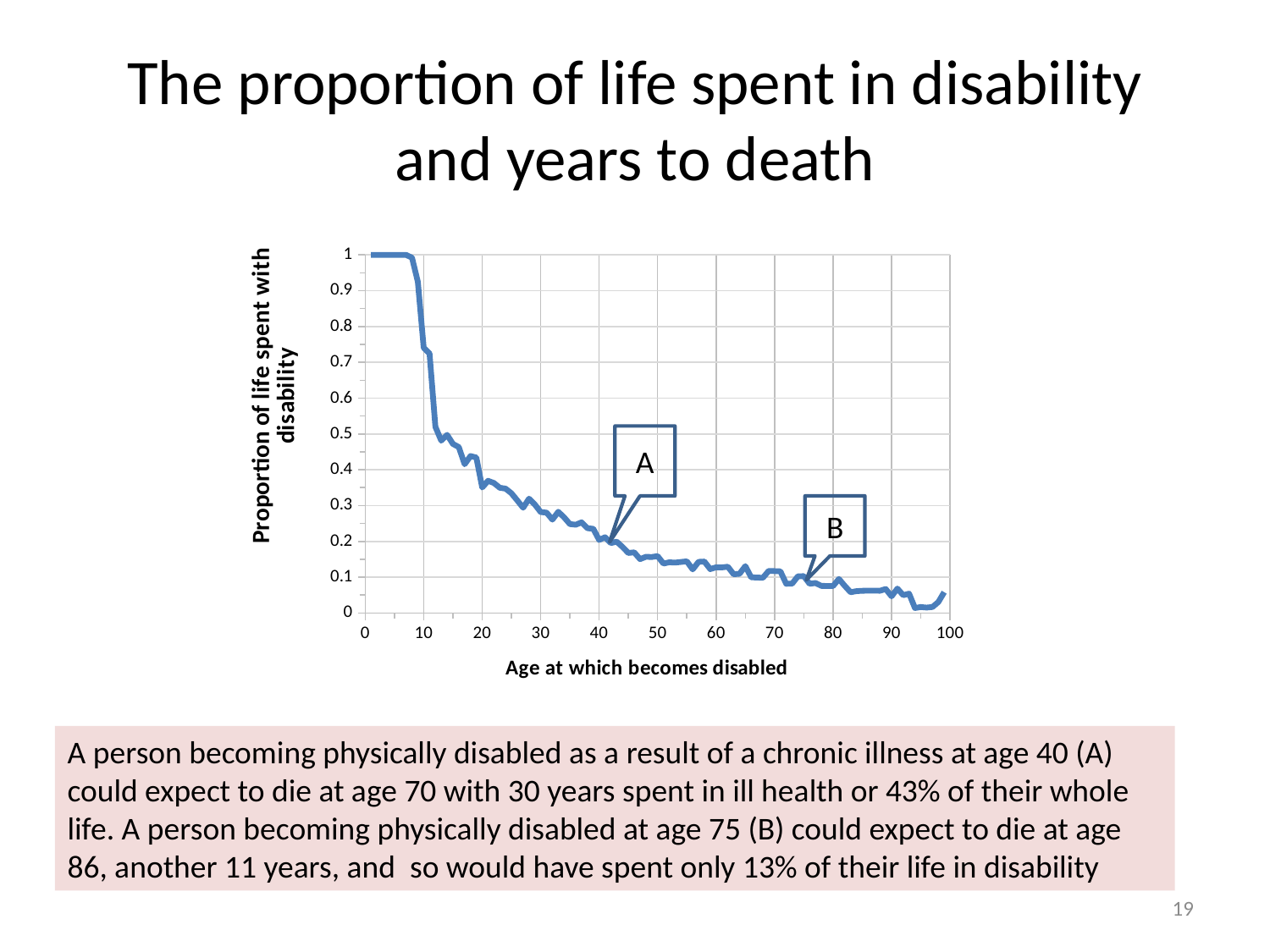
Does the proportion of life spent with disability rise or fall as the age at which a person becomes disabled increases? Fall Is the proportion of life spent with disability at age 40 greater or less than 0.3? less At which end of the age range is the proportion of life spent with disability highest? The youngest ages (near 0) Is the proportion of life spent with disability at age 20 greater or less than 0.3? greater Is the proportion of life spent with disability at age 75 greater or less than 0.2? less Which has a higher proportion of life spent with disability: becoming disabled at age 20 or at age 60? Age 20 What is the title of the slide containing the chart? The proportion of life spent in disability and years to death What kind of chart is shown on the slide? Line chart What are the two labelled callout points marked on the line? A and B